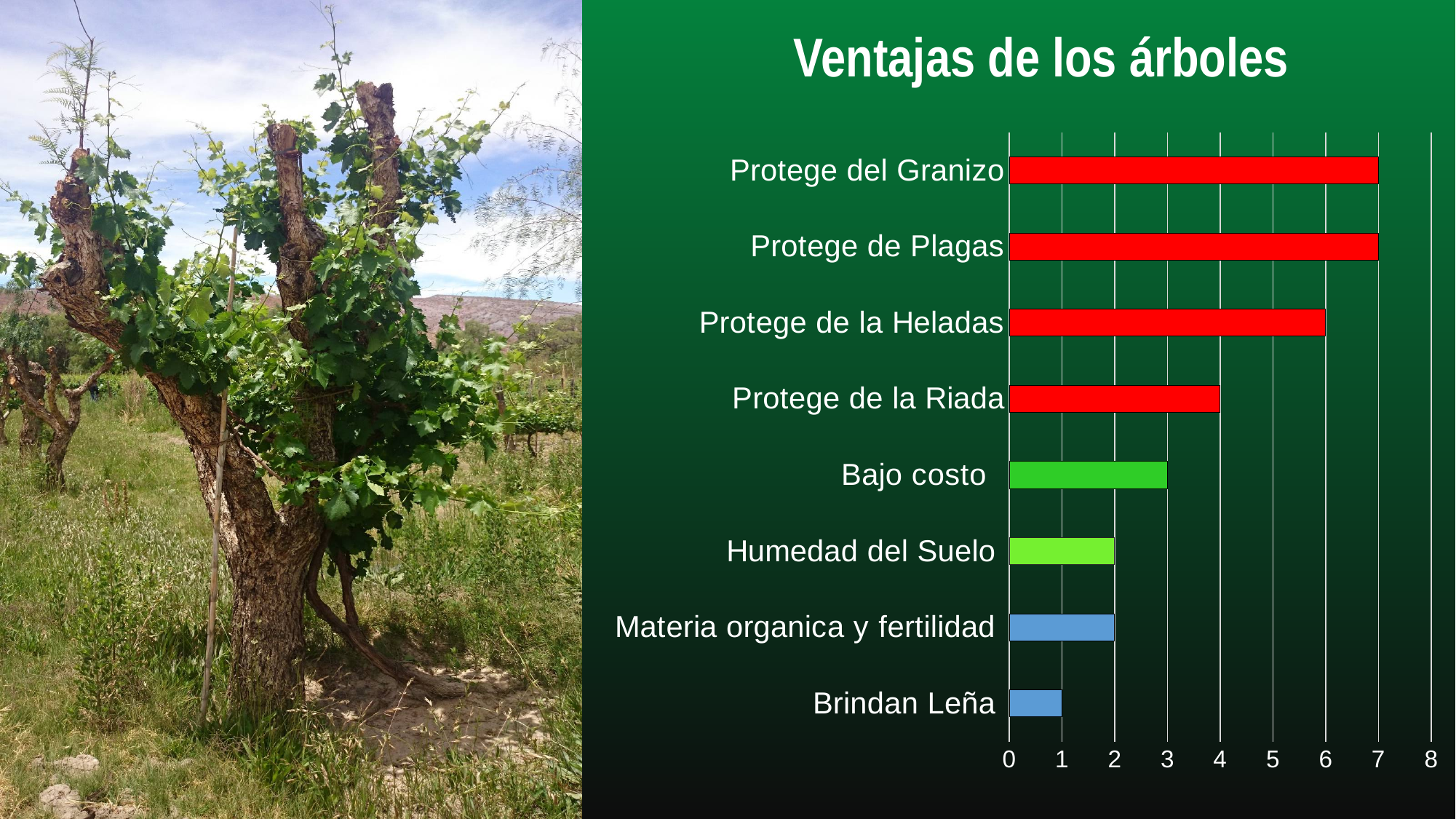
Is the value for Protege de Plagas greater or less than 5? greater How many categories are plotted in the chart? 8 What is the value for Protege de la Riada? 4 What is the value for Bajo costo? 3 What is the value for Brindan Leña? 1 What colour are the bars for the four 'Protege' categories? red Which is larger, the value for Protege de la Heladas or the value for Bajo costo? Protege de la Heladas What is the difference between the values for Protege del Granizo and Protege de la Riada? 3 What is the value for Protege de la Heladas? 6 What is the title of the chart? Ventajas de los árboles Which category has the lowest value? Brindan Leña What type of chart is shown on the slide? bar chart